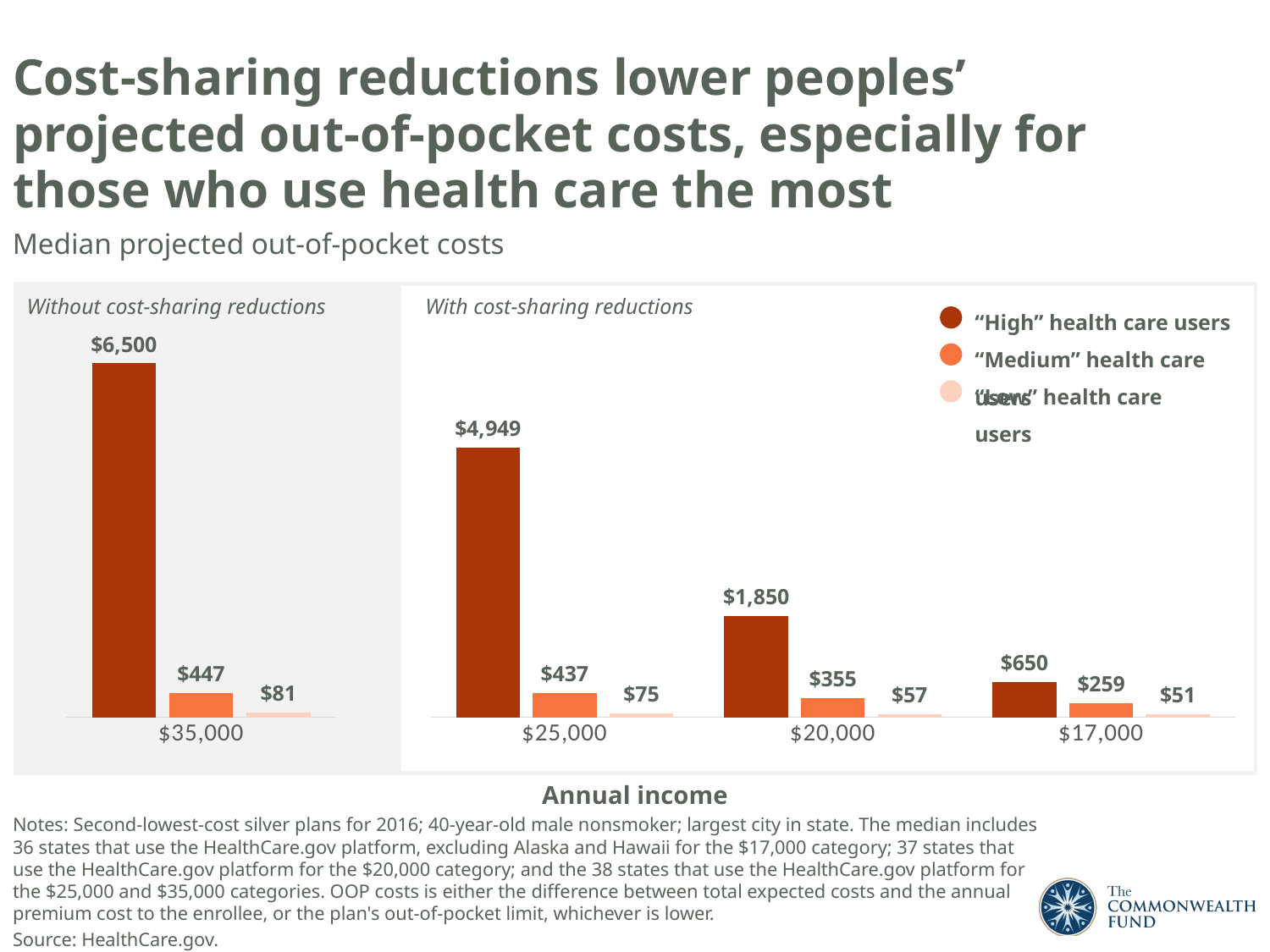
What is the difference between the "High" health care users value at $35,000 in the "Without cost-sharing reductions" chart and the "High" health care users value at $25,000 in the "With cost-sharing reductions" chart? $1,551 What kind of chart is used to show the median projected out-of-pocket costs? Bar chart In the "With cost-sharing reductions" chart, what is the difference between the "High" health care users values at $20,000 and $17,000? $1,200 Which is larger: the "Medium" health care users value at $35,000 in the "Without cost-sharing reductions" chart, or the "Medium" health care users value at $25,000 in the "With cost-sharing reductions" chart? $35,000 without cost-sharing reductions ($447) In the "With cost-sharing reductions" chart, what is the value for "Medium" health care users at $20,000 annual income? $355 In the "With cost-sharing reductions" chart, what is the value for "Low" health care users at $17,000 annual income? $51 In the "With cost-sharing reductions" chart, do the values for "High" health care users rise or fall as annual income goes from $25,000 to $17,000? Fall In the "Without cost-sharing reductions" chart, what is the median projected out-of-pocket cost for "High" health care users at $35,000 annual income? $6,500 How many annual income categories are shown in the "With cost-sharing reductions" chart? 3 In the "With cost-sharing reductions" chart, which annual income category has the lowest value for "Medium" health care users? $17,000 How many series does the legend list? 3 In the "With cost-sharing reductions" chart, which annual income category has the highest value for "High" health care users? $25,000